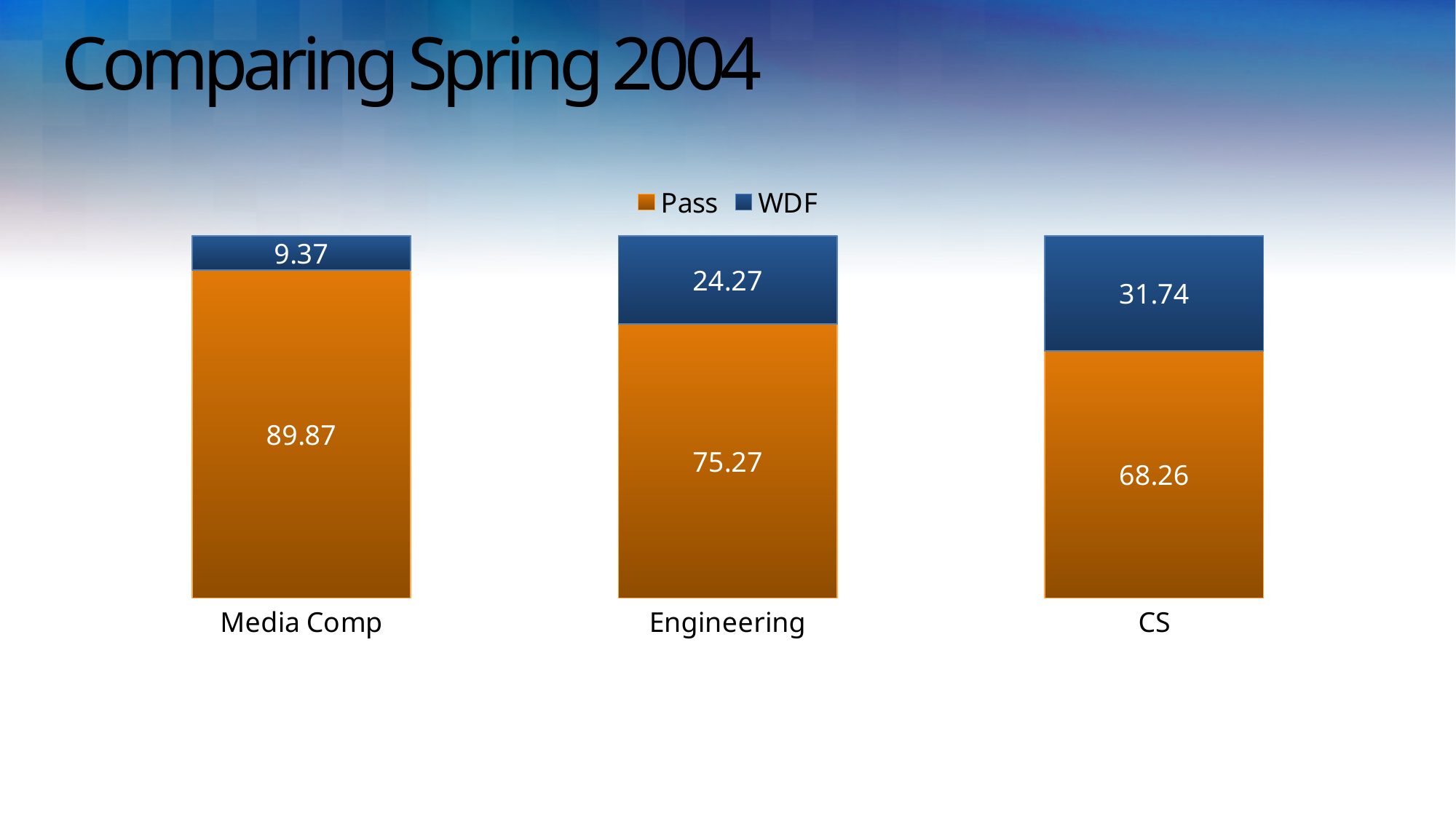
How many series does the legend list? 2 Which category has the lowest WDF value? Media Comp Which category has the highest Pass value? Media Comp Which colour represents the WDF series? Blue What is the Pass value for Media Comp? 89.87 What is the WDF value for Media Comp? 9.37 What kind of chart is shown on the slide? Stacked bar chart What is the WDF value for CS? 31.74 What is the difference between the Pass values for Media Comp and CS? 21.61 Which is larger, the WDF value for Engineering or the WDF value for CS? CS What is the Pass value for Engineering? 75.27 How many categories are shown on the x axis? 3